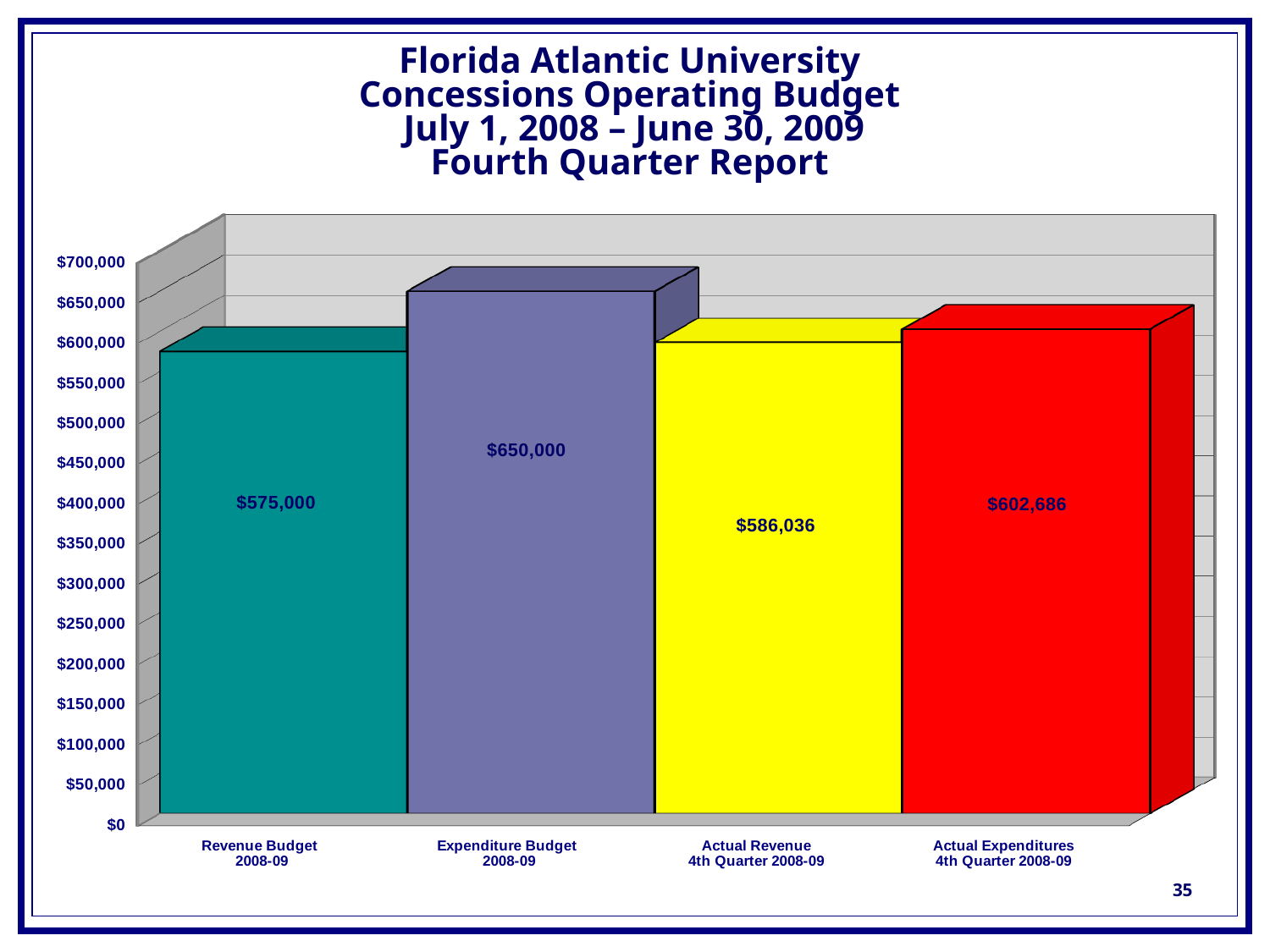
What is the value for Actual Expenditures 4th Quarter 2008-09? $602,686 What is the difference between Actual Revenue 4th Quarter 2008-09 and Revenue Budget 2008-09? $11,036 What is the value for Expenditure Budget 2008-09? $650,000 Which category has the highest value? Expenditure Budget 2008-09 Which category has the lowest value? Revenue Budget 2008-09 What colour is the bar for Actual Revenue 4th Quarter 2008-09? Yellow What is the value for Actual Revenue 4th Quarter 2008-09? $586,036 How many categories are shown in the chart? 4 What is the difference between Expenditure Budget 2008-09 and Actual Expenditures 4th Quarter 2008-09? $47,314 What is the value for Revenue Budget 2008-09? $575,000 What kind of chart is shown on the slide? Bar chart Which is larger, Actual Revenue 4th Quarter 2008-09 or Actual Expenditures 4th Quarter 2008-09? Actual Expenditures 4th Quarter 2008-09